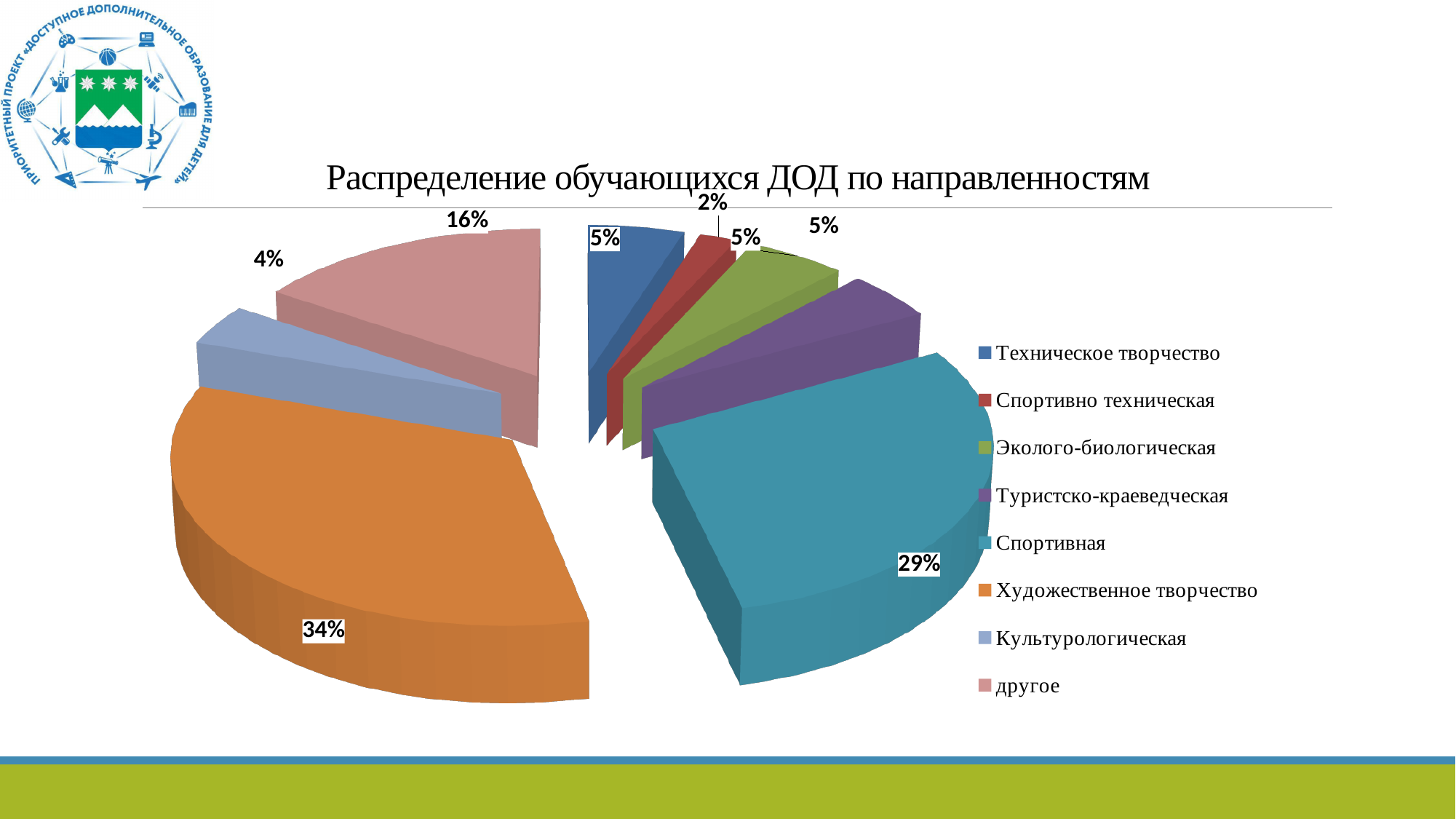
What share of the pie does Спортивная have? 29% What share of the pie does Художественное творчество have? 34% How many categories does the legend of the pie chart list? 8 Which is larger, the share of другое or the share of Культурологическая? другое What share of the pie does Спортивно техническая have? 2% Which category has the largest share of the pie? Художественное творчество Which category has the smallest share of the pie? Спортивно техническая What is the difference between the shares of Художественное творчество and Спортивная? 5% What is the title of the chart? Распределение обучающихся ДОД по направленностям What kind of chart is shown on the slide? pie chart